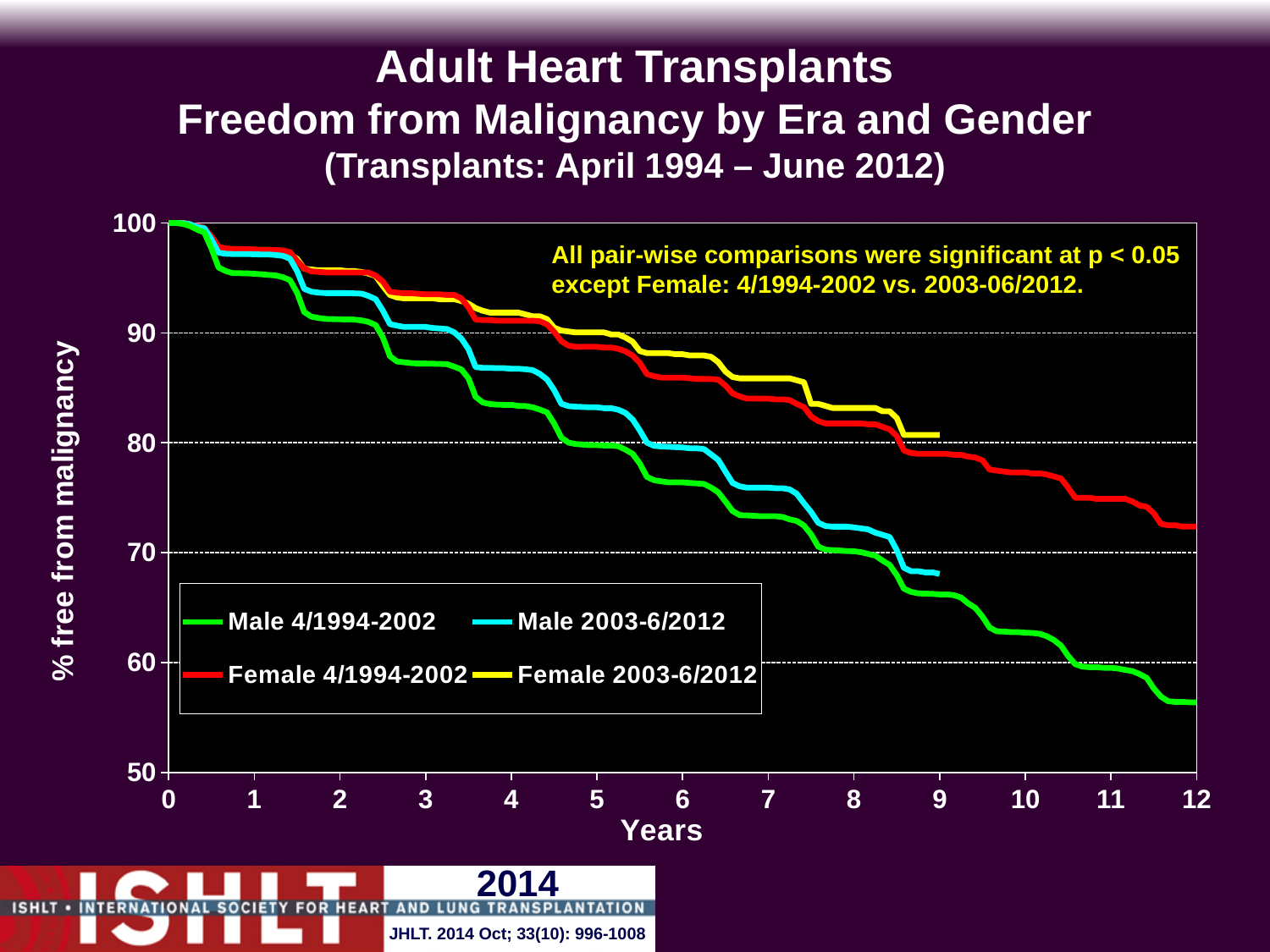
At 12 years, which is higher: Female 4/1994-2002 or Male 4/1994-2002? Female 4/1994-2002 Is the value for Female 2003-6/2012 at 8 years greater or less than 80? greater How many series does the legend list? 4 Is the value for Female 4/1994-2002 at 12 years greater or less than 70? greater Is the value for Male 4/1994-2002 at 6 years greater or less than 80? less Do the values for Male 4/1994-2002 rise or fall as years increase? fall Which comparison is noted as the exception to significance at p < 0.05? Female: 4/1994-2002 vs. 2003-06/2012 What is the label of the y axis? % free from malignancy At 6 years, which series has the lowest value? Male 4/1994-2002 What kind of chart is shown on the slide? line chart